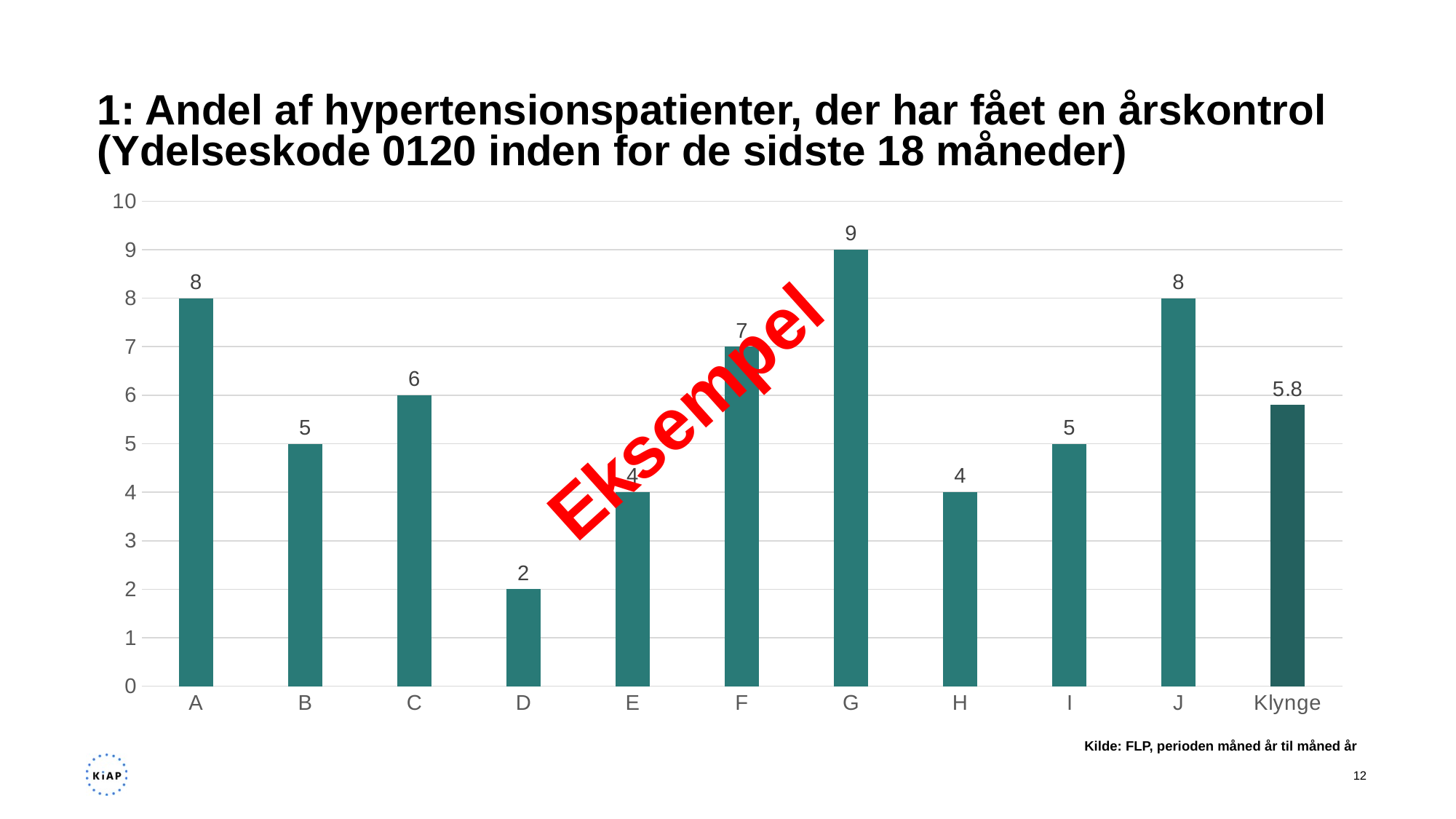
What is the difference between the values for G and D? 7 Which is larger, the value for C or the value for H? C What kind of chart is shown on the slide? bar chart Which category has the lowest value? D Is the value for F greater or less than 5? greater Which category has the highest value? G What is the value for category G? 9 What is the difference between the values for J and Klynge? 2.2 What red word is written diagonally across the chart? Eksempel What is the value for Klynge? 5.8 What is the value for category D? 2 How many categories are shown on the x axis? 11